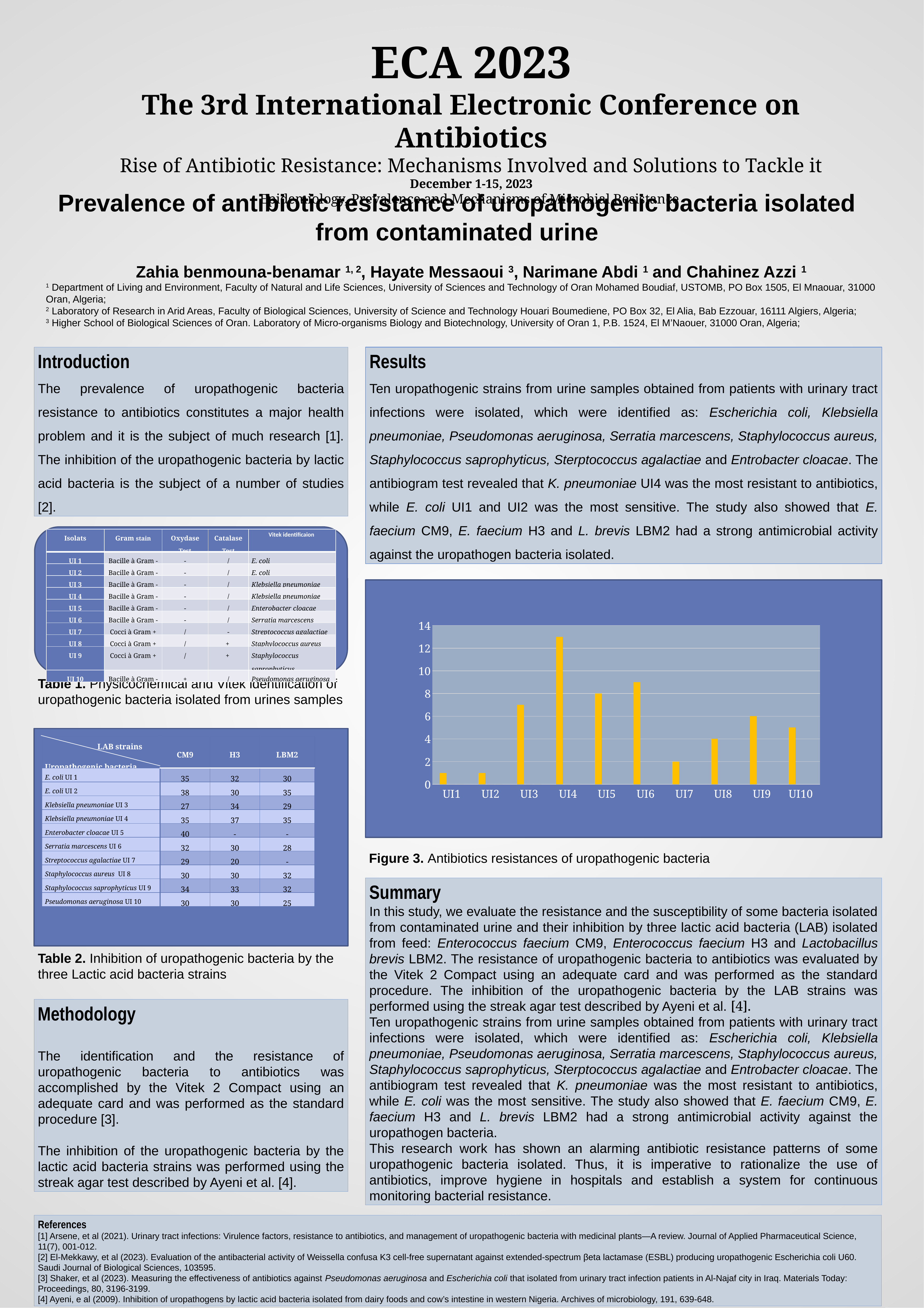
Is the value for UI10 greater or less than 6? less What is the caption given for the chart in Figure 3? Antibiotics resistances of uropathogenic bacteria What is the value for UI9 in the chart? 6 What is the value for UI5 in the chart? 8 Is the value for UI4 greater or less than 12? greater What is the difference between the values for UI5 and UI7? 6 Which has the larger value, UI6 or UI3? UI6 What is the value for UI8 in the chart? 4 What kind of chart is shown in Figure 3? bar chart Which isolate has the highest value in the chart? UI4 How many categories (isolates) are plotted on the x axis of the chart? 10 What is the value for UI7 in the chart? 2